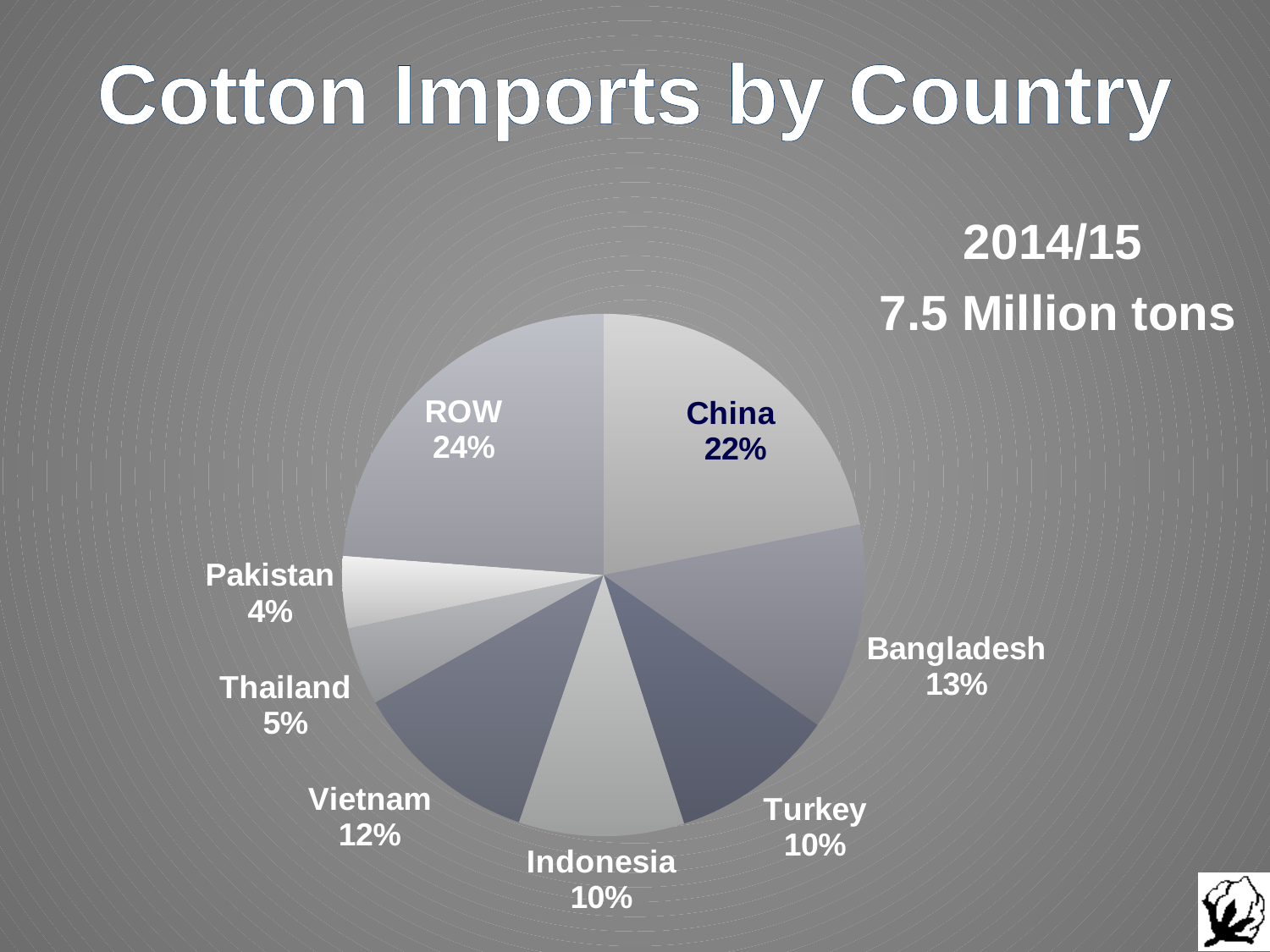
What is the difference in percentage points between ROW and China? 2 What kind of chart is shown on the slide? pie chart What share of cotton imports does Bangladesh account for? 13% Which slice of the pie is the largest? ROW How many slices does the pie chart have? 8 What is the title of the chart? Cotton Imports by Country Which is larger, the share for Thailand or the share for Vietnam? Vietnam What share of cotton imports does Pakistan account for? 4% What is the combined share of Turkey and Indonesia? 20% Which slice of the pie is the smallest? Pakistan What share of cotton imports does Vietnam account for? 12% What share of cotton imports does China account for? 22%